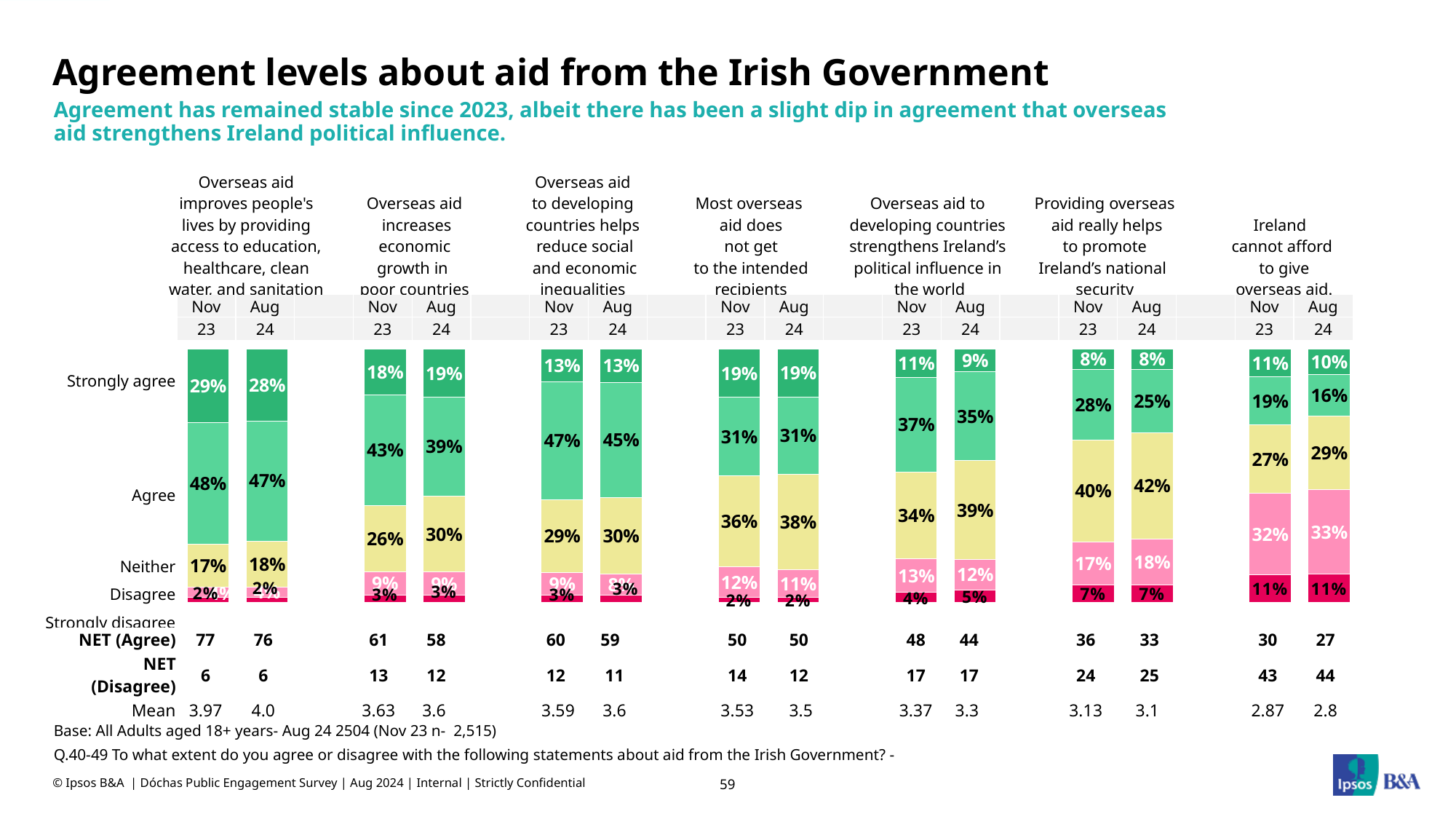
By how many points did the NET (Agree) figure for 'Overseas aid to developing countries strengthens Ireland's political influence in the world' change from Nov 23 to Aug 24? 4 What is the NET (Agree) figure for Aug 24 for the statement that overseas aid to developing countries strengthens Ireland's political influence in the world? 44 What type of chart is used on this slide? Stacked bar chart Which statement has the lowest mean score in Aug 24? Ireland cannot afford to give overseas aid. What is the mean score for Nov 23 for the statement that most overseas aid does not get to the intended recipients? 3.53 How many statements about aid from the Irish Government are shown in the chart? 7 What percentage agreed in Nov 23 that overseas aid to developing countries helps reduce social and economic inequalities? 47% How many response categories are stacked in each bar? 5 What percentage answered 'Neither' in Aug 24 for the statement that providing overseas aid really helps to promote Ireland's national security? 42% What percentage strongly agreed in Aug 24 that overseas aid improves people's lives by providing access to education, healthcare, clean water, and sanitation? 28% Which is larger: the 'Disagree' share in Aug 24 for 'Ireland cannot afford to give overseas aid' or the 'Disagree' share in Aug 24 for 'Providing overseas aid really helps to promote Ireland's national security'? Ireland cannot afford to give overseas aid (33%) Which statement has the highest NET (Agree) figure in Nov 23? Overseas aid improves people's lives by providing access to education, healthcare, clean water, and sanitation